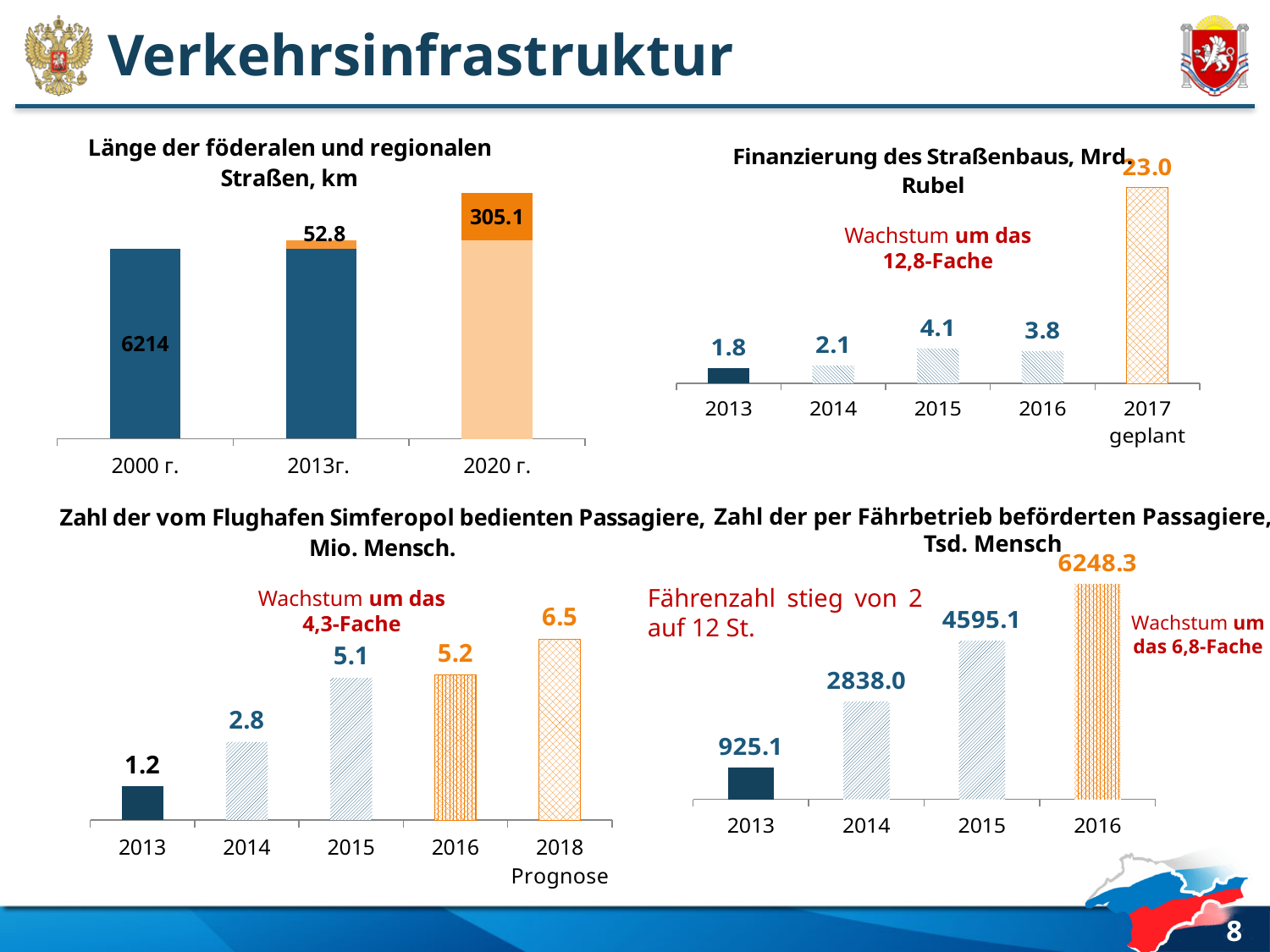
In the chart 'Zahl der per Fährbetrieb beförderten Passagiere, Tsd. Mensch', do the values rise or fall from 2013 to 2016? rise In the chart 'Finanzierung des Straßenbaus, Mrd. Rubel', what is the difference between the values for 2016 and 2013? 2.0 In the chart 'Finanzierung des Straßenbaus, Mrd. Rubel', how many years are shown on the x axis? 5 In the chart 'Länge der föderalen und regionalen Straßen, km', what value is labelled on the bar for 2000 г.? 6214 In the chart 'Zahl der per Fährbetrieb beförderten Passagiere, Tsd. Mensch', what is the value for 2015? 4595.1 In the chart 'Finanzierung des Straßenbaus, Mrd. Rubel', what is the value for 2015? 4.1 In the chart 'Zahl der vom Flughafen Simferopol bedienten Passagiere, Mio. Mensch.', what is the difference between the 2018 Prognose value and the 2016 value? 1.3 In the chart 'Zahl der per Fährbetrieb beförderten Passagiere, Tsd. Mensch', which is larger, the value for 2014 or the value for 2015? 2015 What kind of chart is 'Länge der föderalen und regionalen Straßen, km'? stacked bar chart In the chart 'Finanzierung des Straßenbaus, Mrd. Rubel', which year has the highest value? 2017 geplant In the chart 'Zahl der vom Flughafen Simferopol bedienten Passagiere, Mio. Mensch.', which year has the lowest value? 2013 In the chart 'Zahl der vom Flughafen Simferopol bedienten Passagiere, Mio. Mensch.', what is the value for 2014? 2.8